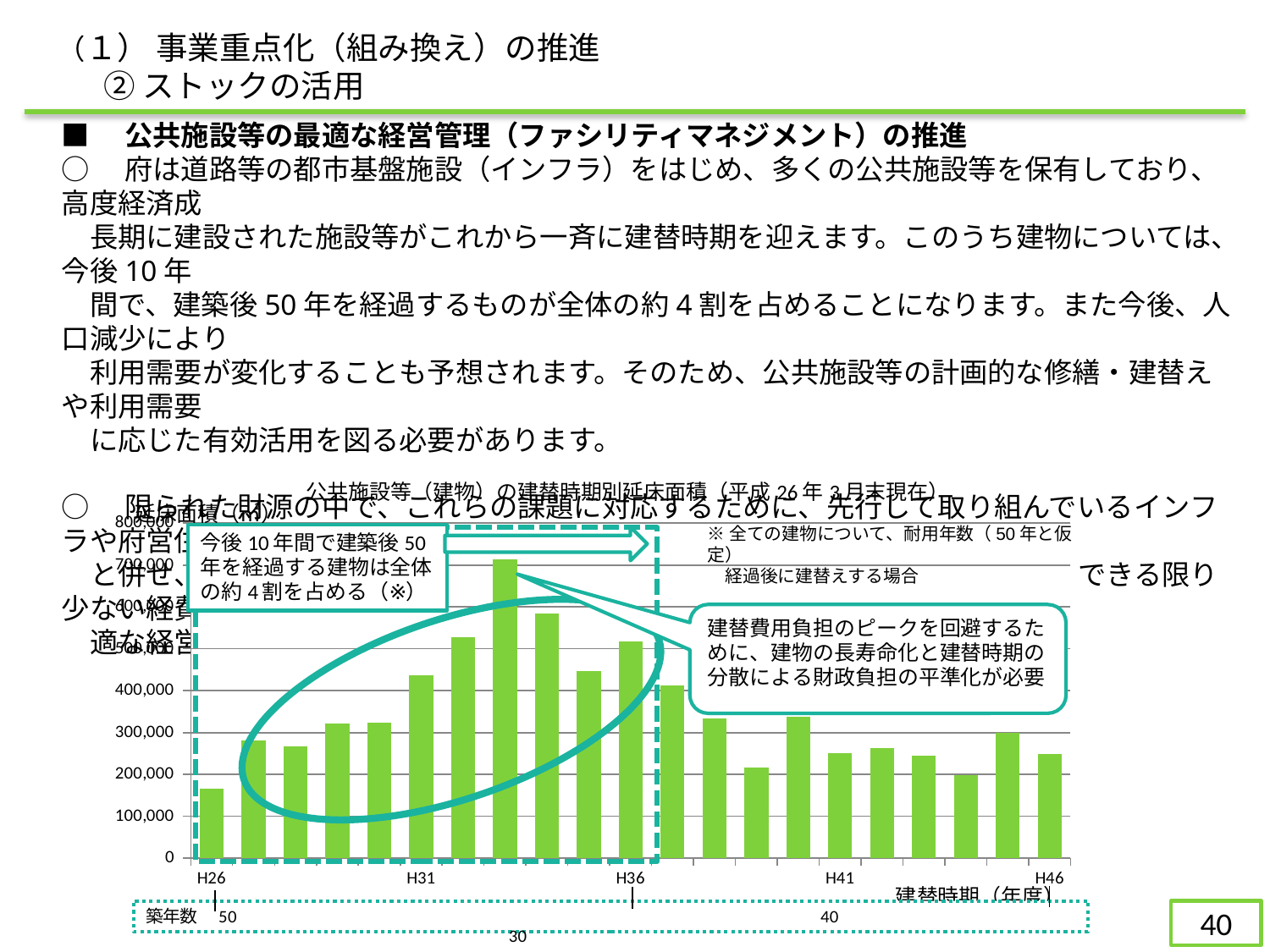
Is the value for H41 greater or less than 300,000? less How many bars are plotted in the chart? 21 What kind of chart is shown on the slide? bar chart Which year has the shortest bar in the chart? H26 Which year has the tallest bar in the chart? H33 Is the value for H31 greater or less than 400,000? greater What is the title of the chart? 公共施設等（建物）の建替時期別延床面積（平成26年3月末現在） Is the value for H26 greater or less than 200,000? less Which is larger, the value for H31 or the value for H26? H31 What is the label of the x axis of the chart? 建替時期（年度） Do the values rise or fall from H26 to H33? rise